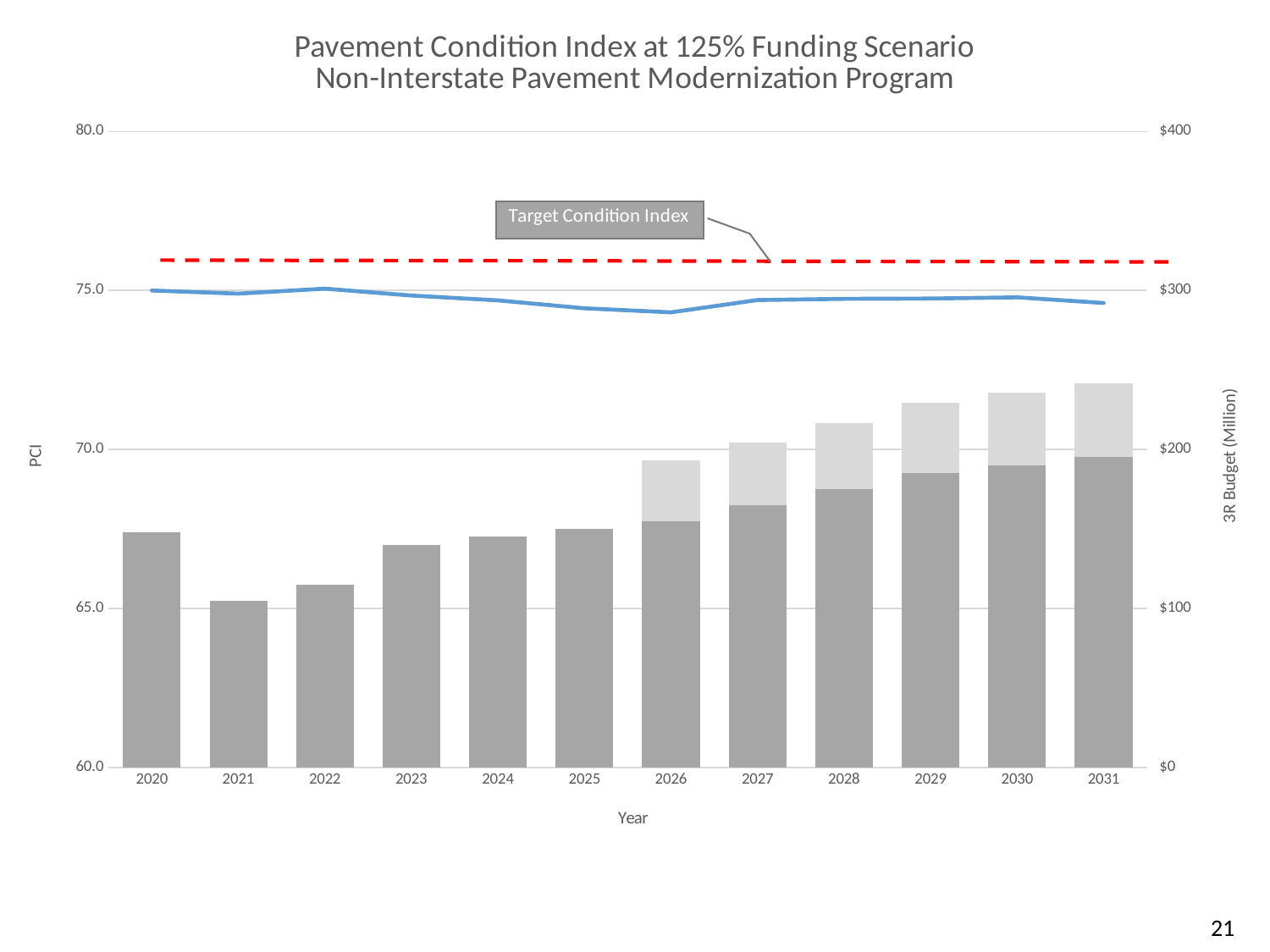
How many years are shown on the x axis? 12 Is the 3R Budget bar for 2020 greater or less than $200 million? less Which year has the lowest 3R Budget bar? 2021 What is the label of the right-hand vertical axis? 3R Budget (Million) Is the total stacked 3R Budget bar for 2031 greater or less than $200 million? greater Is the 3R Budget bar for 2020 greater or less than $100 million? greater What kind of chart is shown on the slide? bar and line chart Which year has the larger 3R Budget bar, 2020 or 2021? 2020 Do the stacked 3R Budget bars generally rise or fall from 2021 to 2031? rise Which year has the tallest stacked 3R Budget bar? 2031